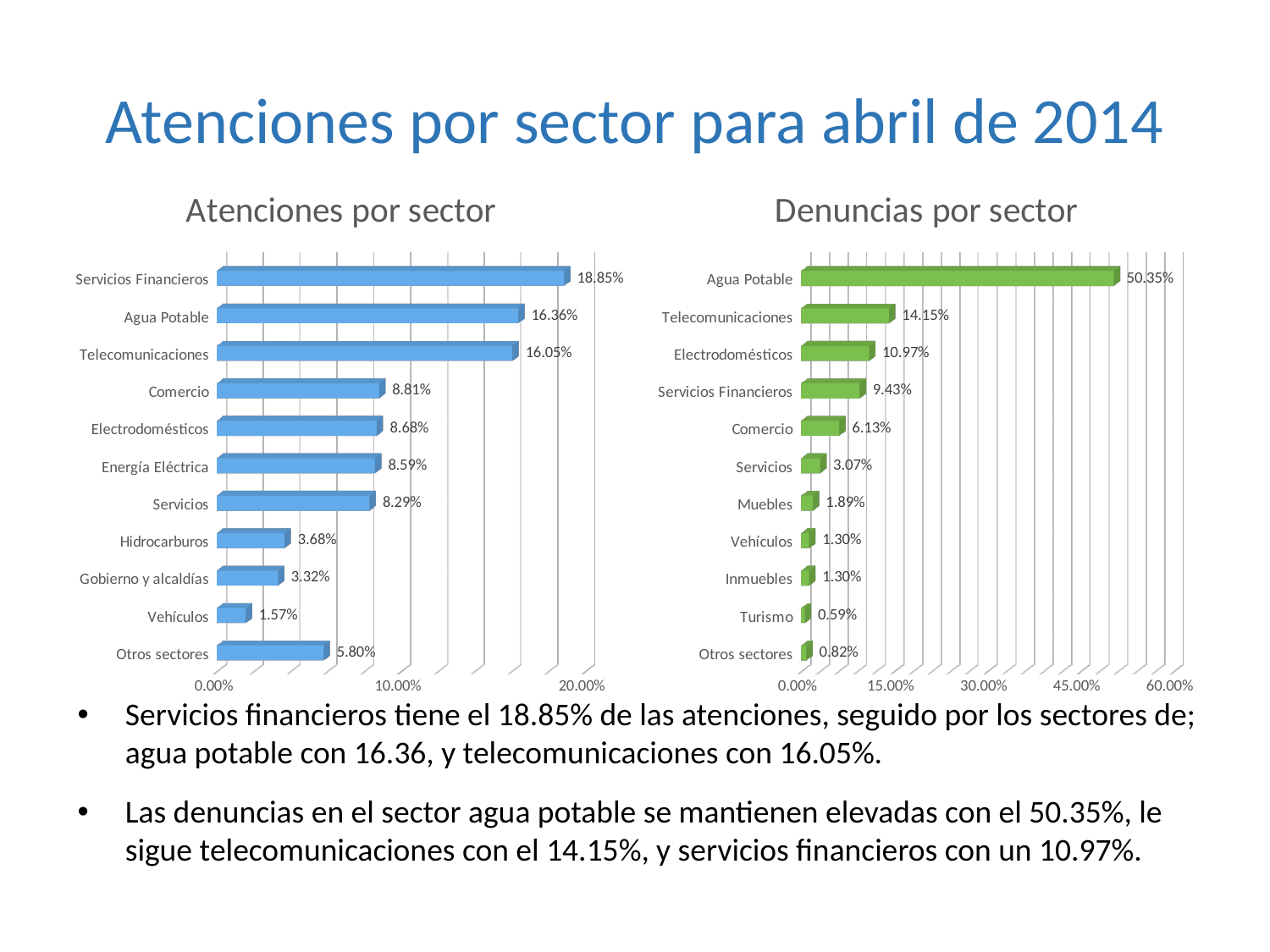
In the 'Atenciones por sector' chart, which category has the lowest value? Vehículos In the 'Denuncias por sector' chart, what is the difference between Telecomunicaciones and Electrodomésticos? 3.18% In the 'Atenciones por sector' chart, what is the value for Gobierno y alcaldías? 3.32% What kind of chart is 'Denuncias por sector'? Bar chart How many categories are shown in the 'Atenciones por sector' chart? 11 In the 'Denuncias por sector' chart, is the value for Agua Potable greater or less than 45.00%? greater In the 'Denuncias por sector' chart, which category has the lowest value? Turismo In the 'Atenciones por sector' chart, what is the difference between Agua Potable and Telecomunicaciones? 0.31% In the 'Atenciones por sector' chart, what is the value for Servicios Financieros? 18.85% In the 'Denuncias por sector' chart, which category has the highest value? Agua Potable In the 'Atenciones por sector' chart, which is larger, Hidrocarburos or Otros sectores? Otros sectores In the 'Denuncias por sector' chart, what is the value for Agua Potable? 50.35%